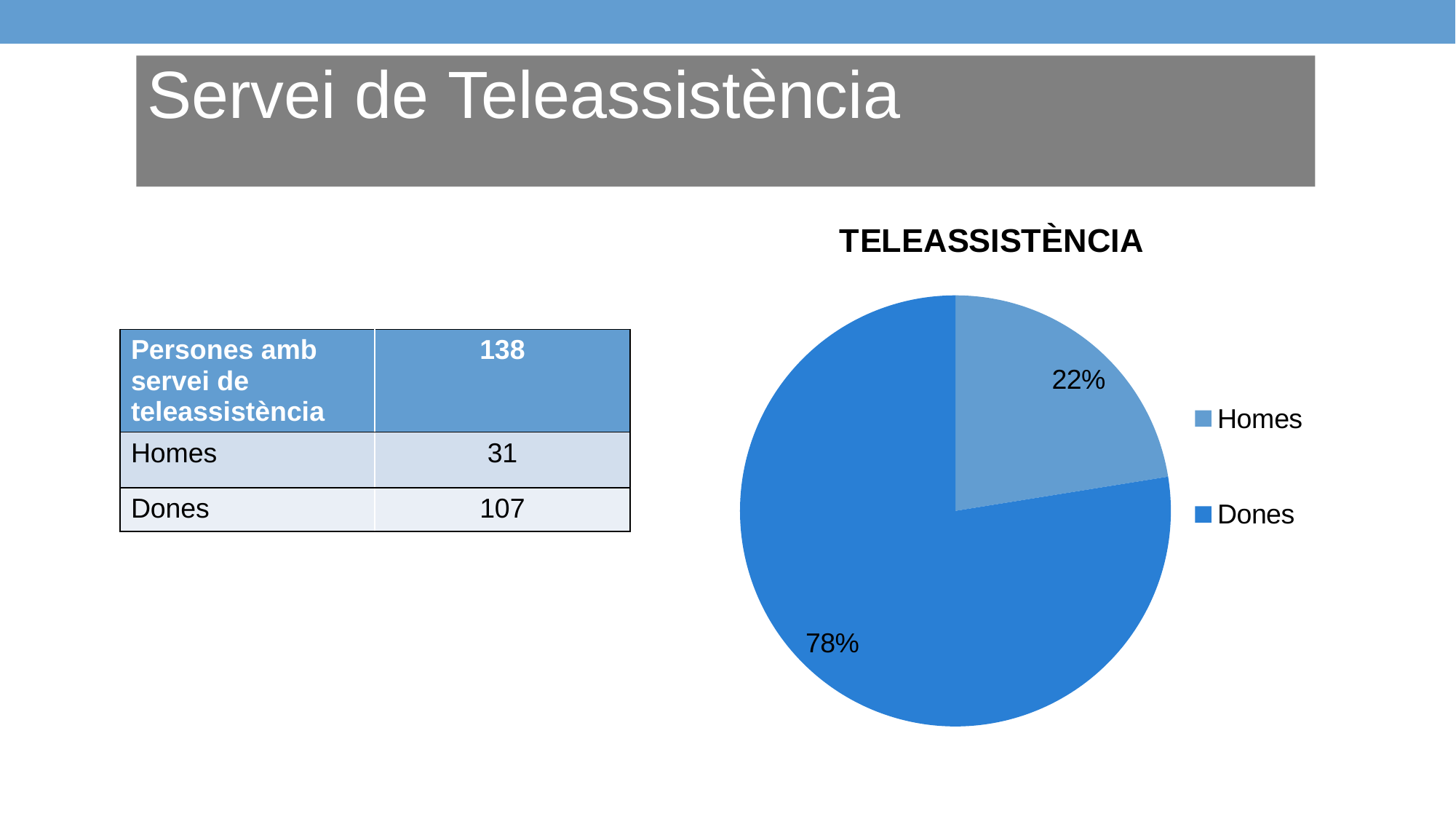
Is the share for Dones greater or less than 50%? greater Is the share for Homes greater or less than 25%? less Which is larger in the pie chart, Homes or Dones? Dones Which slice of the pie is the smallest? Homes How many slices does the pie chart have? 2 How many entries does the legend list? 2 What percentage of the pie does the Homes slice represent? 22% What percentage of the pie does the Dones slice represent? 78% What kind of chart is shown on the slide? pie chart What is the title of the chart? TELEASSISTÈNCIA Which slice of the pie is the largest? Dones What is the difference in percentage points between the Dones and Homes slices? 56%